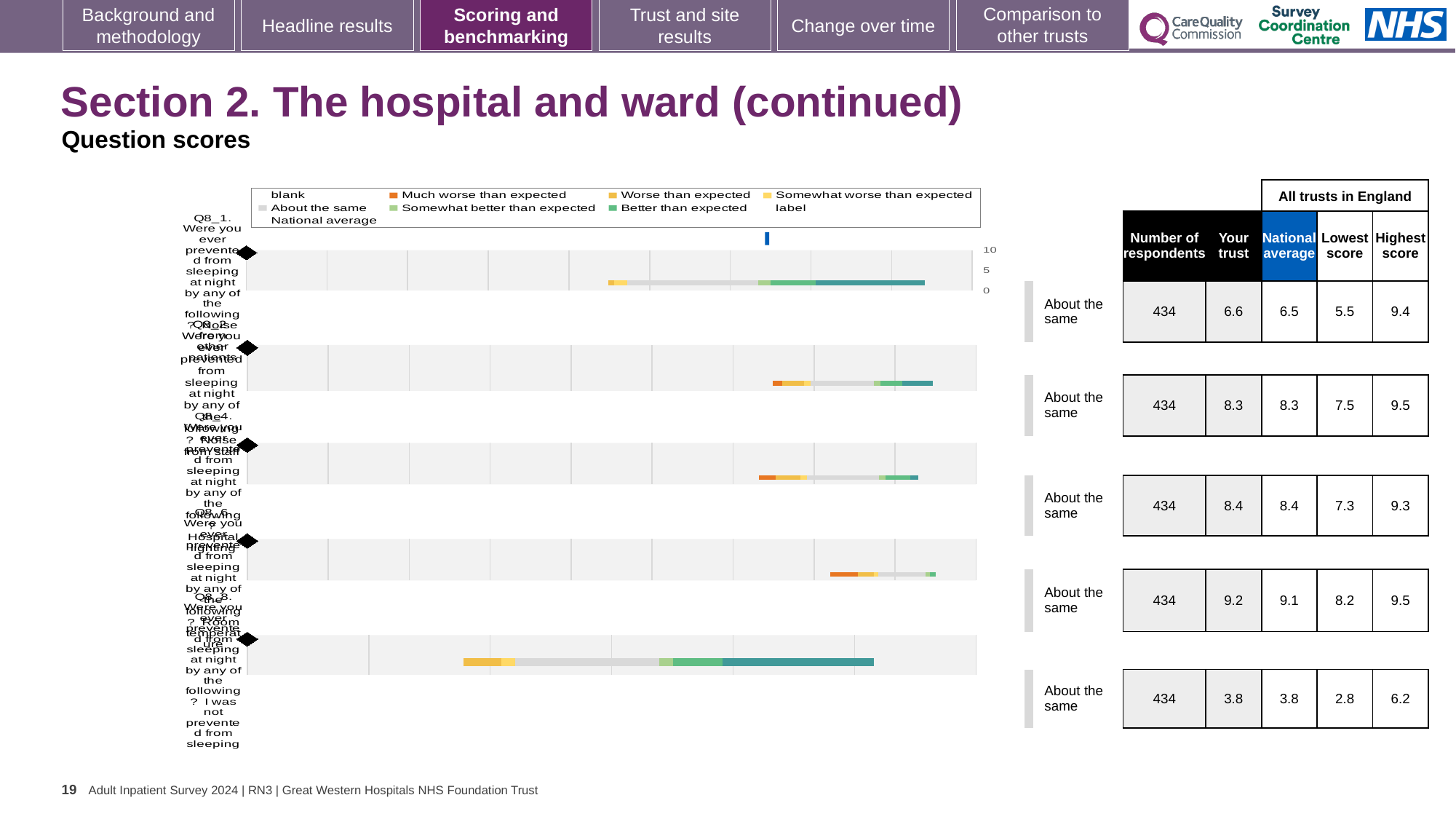
For the fourth row (Q8_6), which is larger: the 'Your trust' score or the national average? Your trust What is the highest score among all trusts in England for the third row (Q8_4)? 9.3 What is the difference between the highest score and the lowest score for the first row (Q8_1)? 3.9 What is the national average for the fifth row (Q8_8)? 3.8 Which row has the highest 'Your trust' score? Q8_6 (fourth row) What is the 'Your trust' score for the first row (Q8_1)? 6.6 Which row has the lowest 'Your trust' score? Q8_8 (fifth row) What kind of chart is shown on the slide? bar chart How many respondents are listed for each question row? 434 What benchmark label is shown next to every question row? About the same How many question rows (bars) are plotted in the chart? 5 What is the lowest score among all trusts in England for the second row (Q8_2)? 7.5